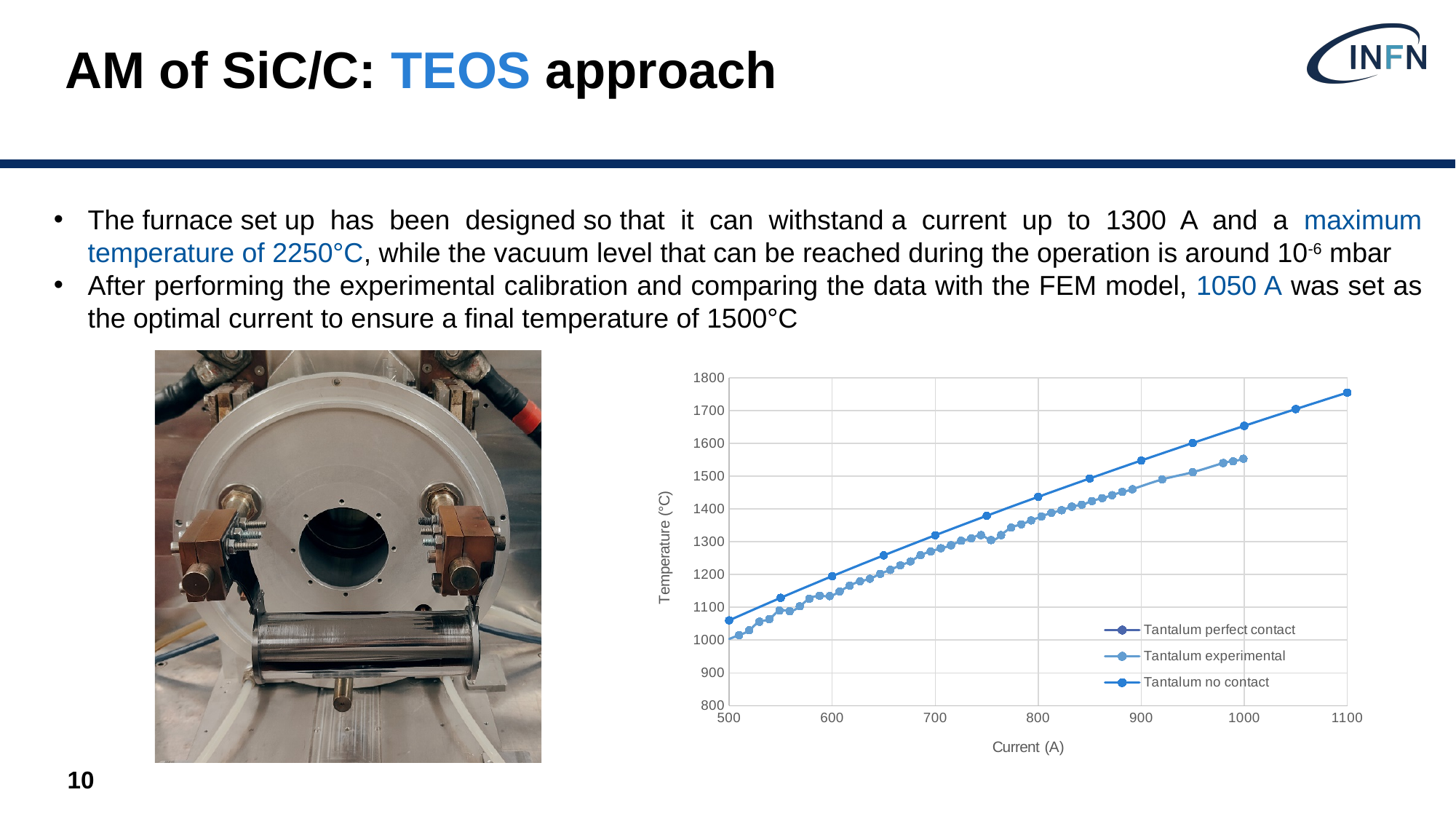
How many series does the chart legend list? 3 Does the temperature for the Tantalum no contact series rise or fall as current increases? rise At 1000 A, which series shows the higher temperature, Tantalum no contact or Tantalum experimental? Tantalum no contact Is the temperature for Tantalum no contact at 1100 A greater or less than 1700? greater What is the title of the y axis of the chart? Temperature (°C) Is the temperature for Tantalum experimental at 800 A greater or less than 1400? less Is the temperature for Tantalum no contact at 800 A greater or less than 1400? greater What kind of chart is shown on the slide? line chart Does the temperature for the Tantalum experimental series rise or fall as current increases? rise What is the title of the x axis of the chart? Current (A)